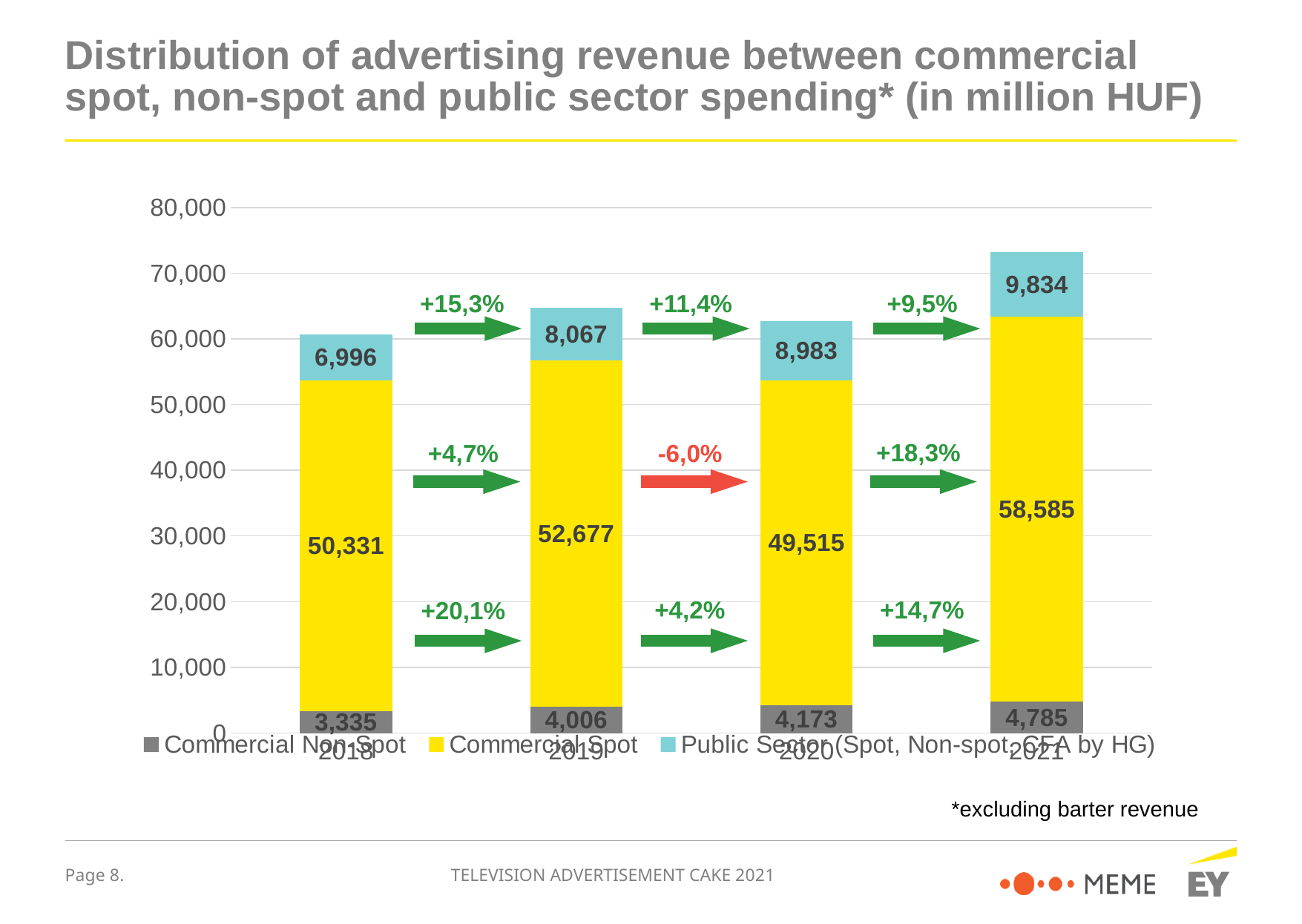
What is the Commercial Non-Spot value for 2018? 3,335 What is the total of the stacked bar for 2021? 73,204 How many years are shown on the x axis? 4 Which is larger, the Commercial Spot value for 2019 or for 2020? 2019 What is the difference between the Commercial Spot values for 2021 and 2020? 9,070 How many series does the legend list? 3 Which year has the lowest Public Sector value? 2018 Which year has the highest Commercial Spot value? 2021 What is the Public Sector value for 2021? 9,834 What is the Commercial Spot value for 2019? 52,677 What percentage change is shown for Commercial Spot between 2019 and 2020? -6,0% What type of chart is shown on the slide? Stacked bar chart